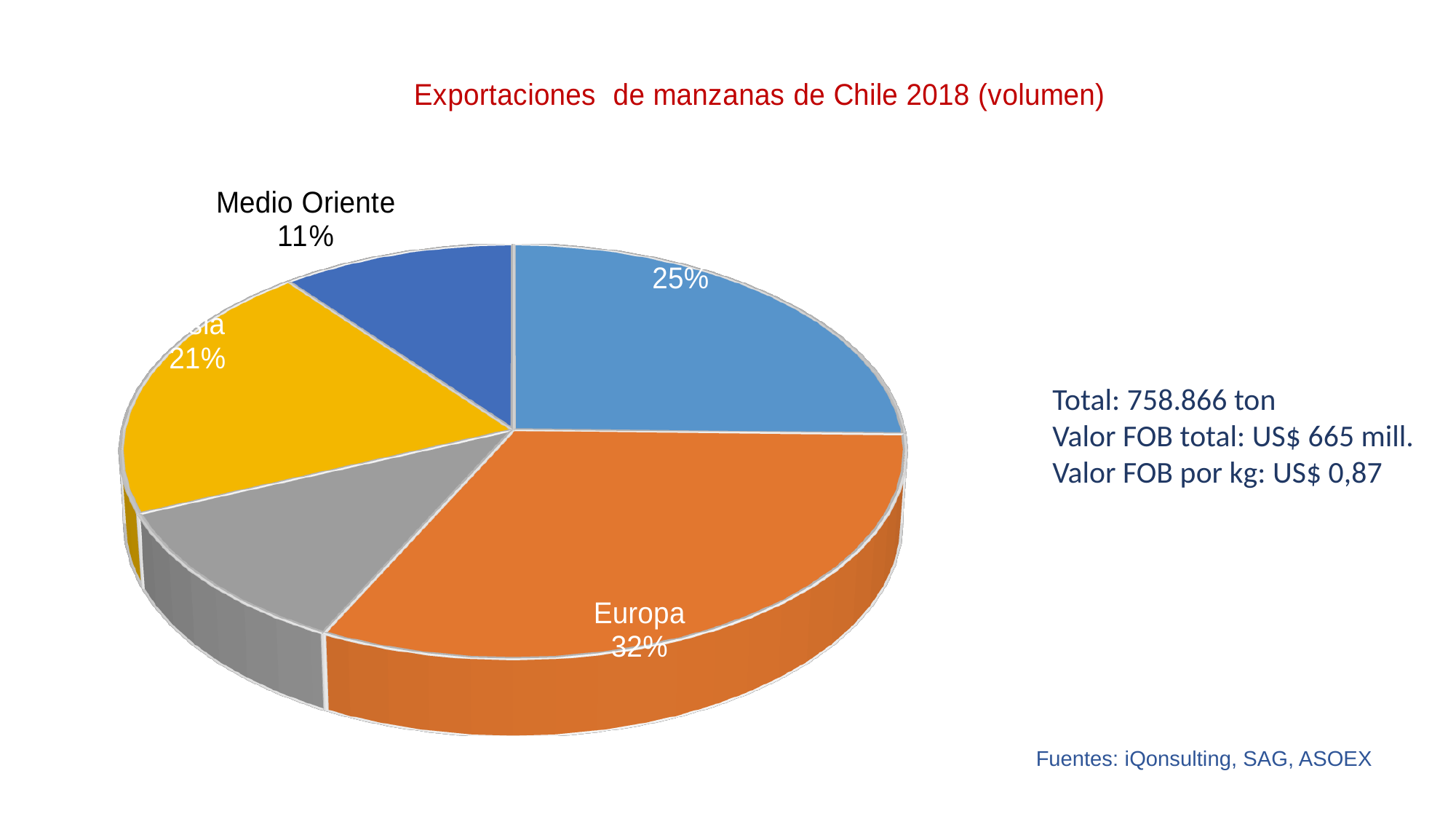
How many slices does the pie chart have? 5 What colour is the Europa slice? orange What share of the pie does Medio Oriente represent? 11% By how many percentage points does Europa's share exceed Medio Oriente's share? 21 Which labelled region has the largest slice of the pie? Europa Which slice is larger, Europa or Medio Oriente? Europa What is the title of the chart? Exportaciones de manzanas de Chile 2018 (volumen) What share of the pie does Europa represent? 32% What kind of chart is shown on the slide? pie chart